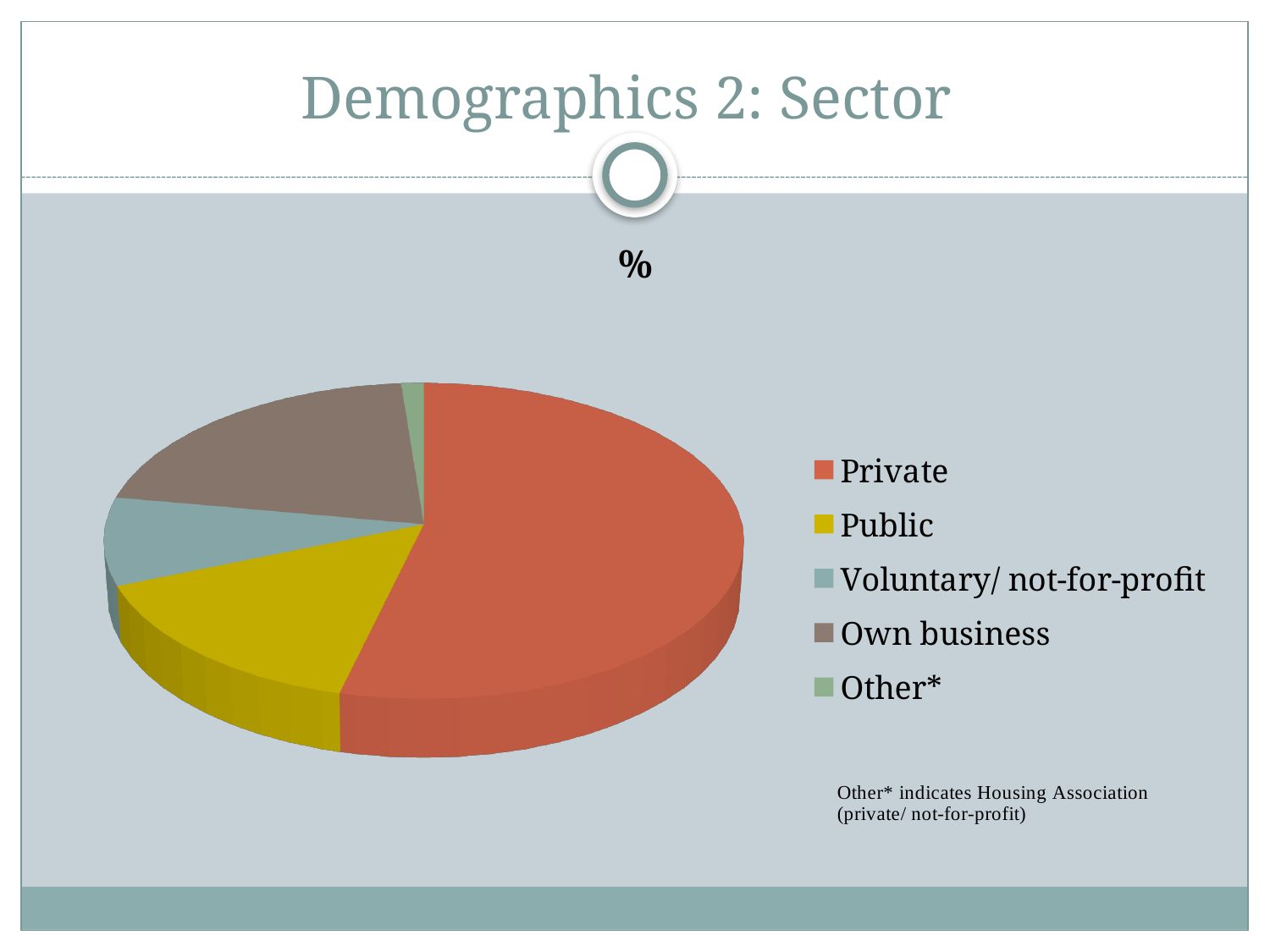
How many categories (slices) does the pie chart have? 5 What colour is the Private slice in the pie chart? Red Which slice is larger, Public or Voluntary/ not-for-profit? Public Which slice is larger, Own business or Voluntary/ not-for-profit? Own business What kind of chart is shown on the slide? Pie chart How many entries does the legend of the pie chart list? 5 What is the title shown above the pie chart? % Which sector has the largest slice of the pie chart? Private Which slice is larger, Own business or Other*? Own business Which sector has the smallest slice of the pie chart? Other*